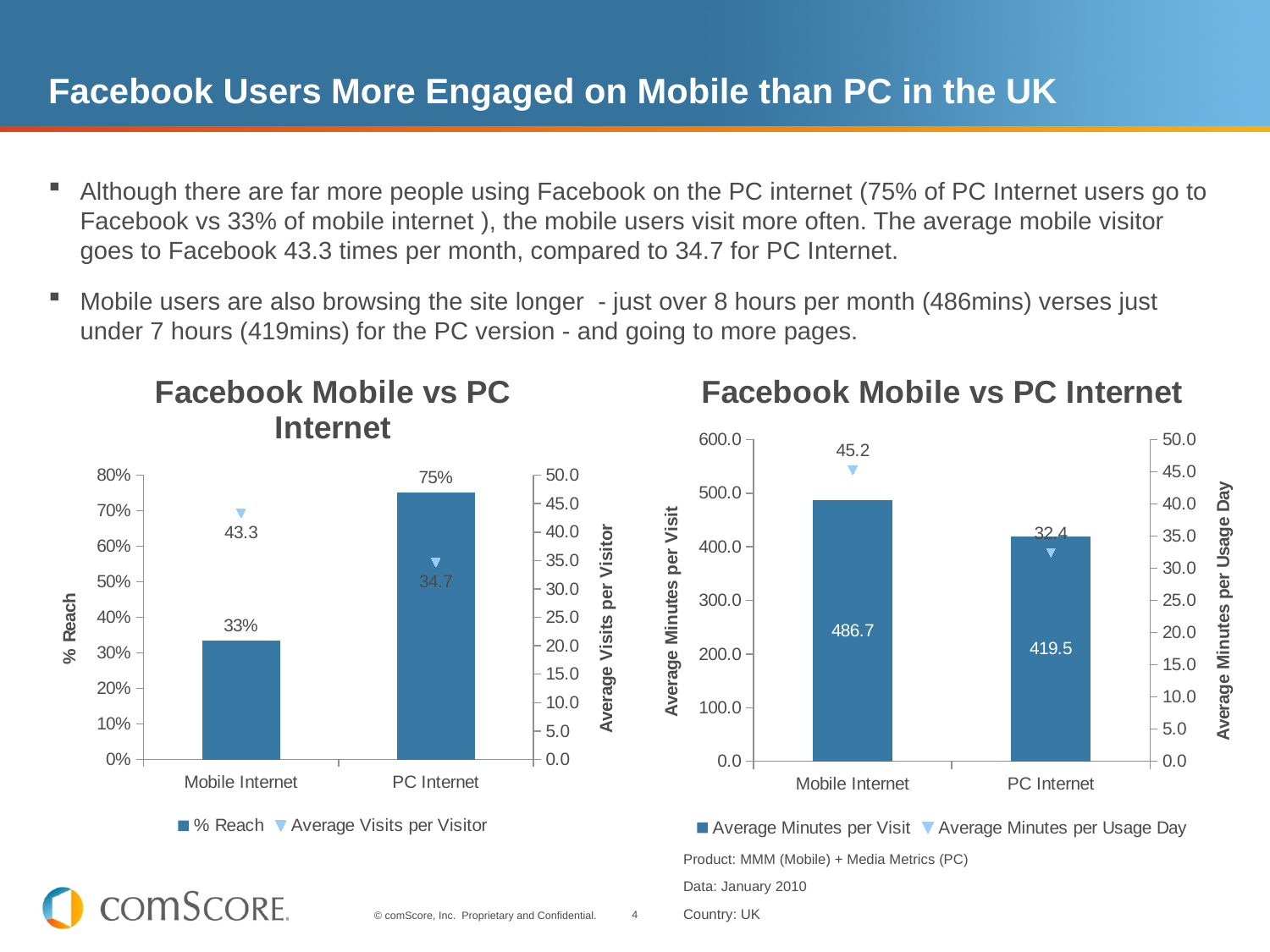
In the left chart, what is the % Reach for PC Internet? 75% In the left chart, which category has the higher % Reach? PC Internet In the right chart, what is the Average Minutes per Visit for Mobile Internet? 486.7 In the left chart, is the Average Visits per Visitor larger for Mobile Internet or PC Internet? Mobile Internet In the left chart, how many series does the legend list? 2 In the left chart, what is the Average Visits per Visitor for Mobile Internet? 43.3 In the right chart, what is the difference in Average Minutes per Visit between Mobile Internet and PC Internet? 67.2 In the right chart, which category has the lower Average Minutes per Usage Day? PC Internet In the left chart, what is the difference in % Reach between PC Internet and Mobile Internet? 42% What type of chart is the right chart? Bar chart In the right chart, what is the Average Minutes per Usage Day for PC Internet? 32.4 In the right chart, how many categories are shown on the x axis? 2